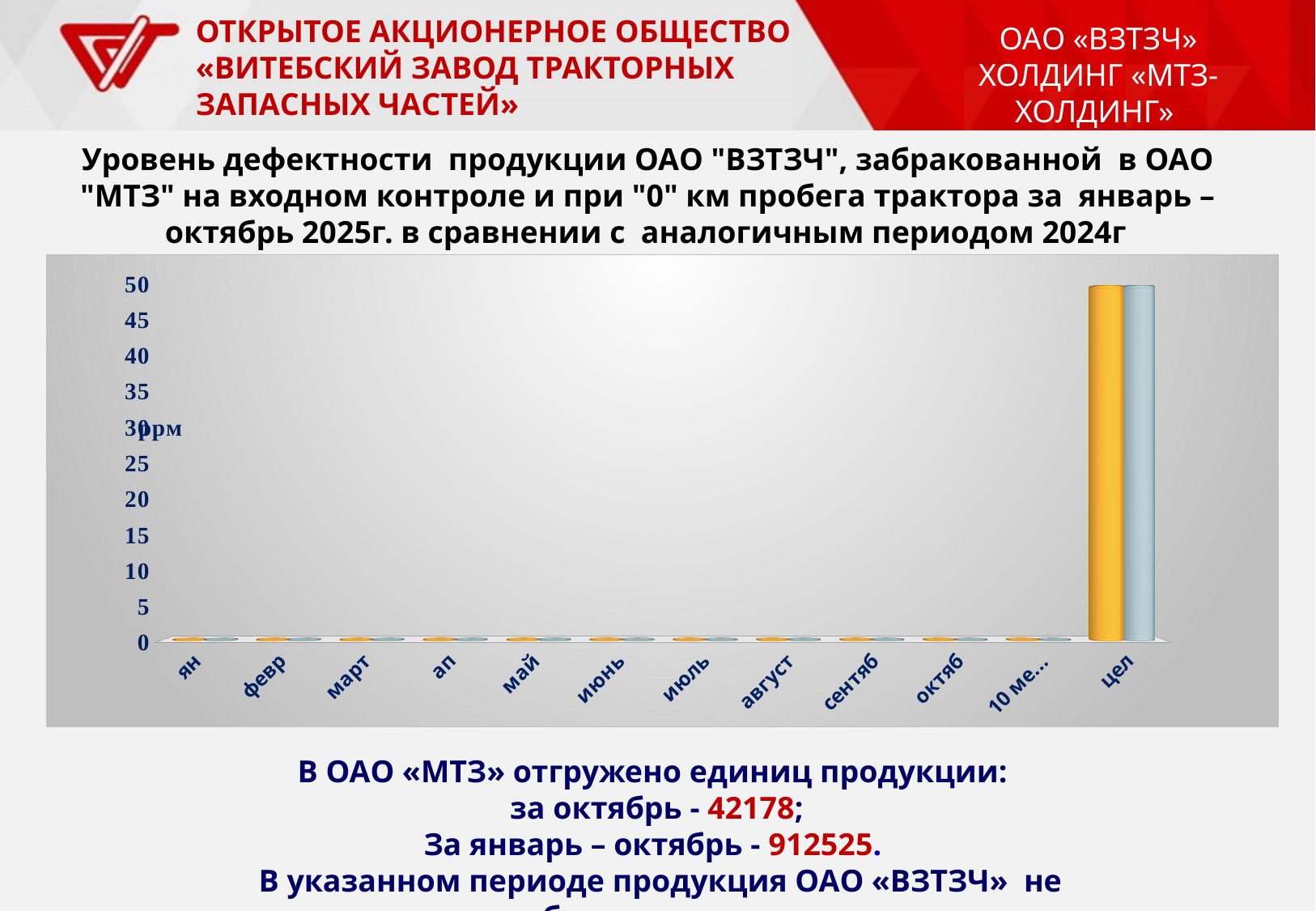
What is the highest value shown on the vertical axis of the chart? 50 Which is larger, the value for "цел" or the value for "10 ме..."? цел Is the value for "январь" (ян) greater or less than 5? less What kind of chart is shown on the slide? bar chart Is the value of the orange bar for "цел" greater or less than 40? greater Is the value of the light blue bar for "цел" greater or less than 45? greater Which category has the highest bars in the chart? цел How many categories are shown along the x axis of the chart? 12 What is the first category on the x axis of the chart? ян